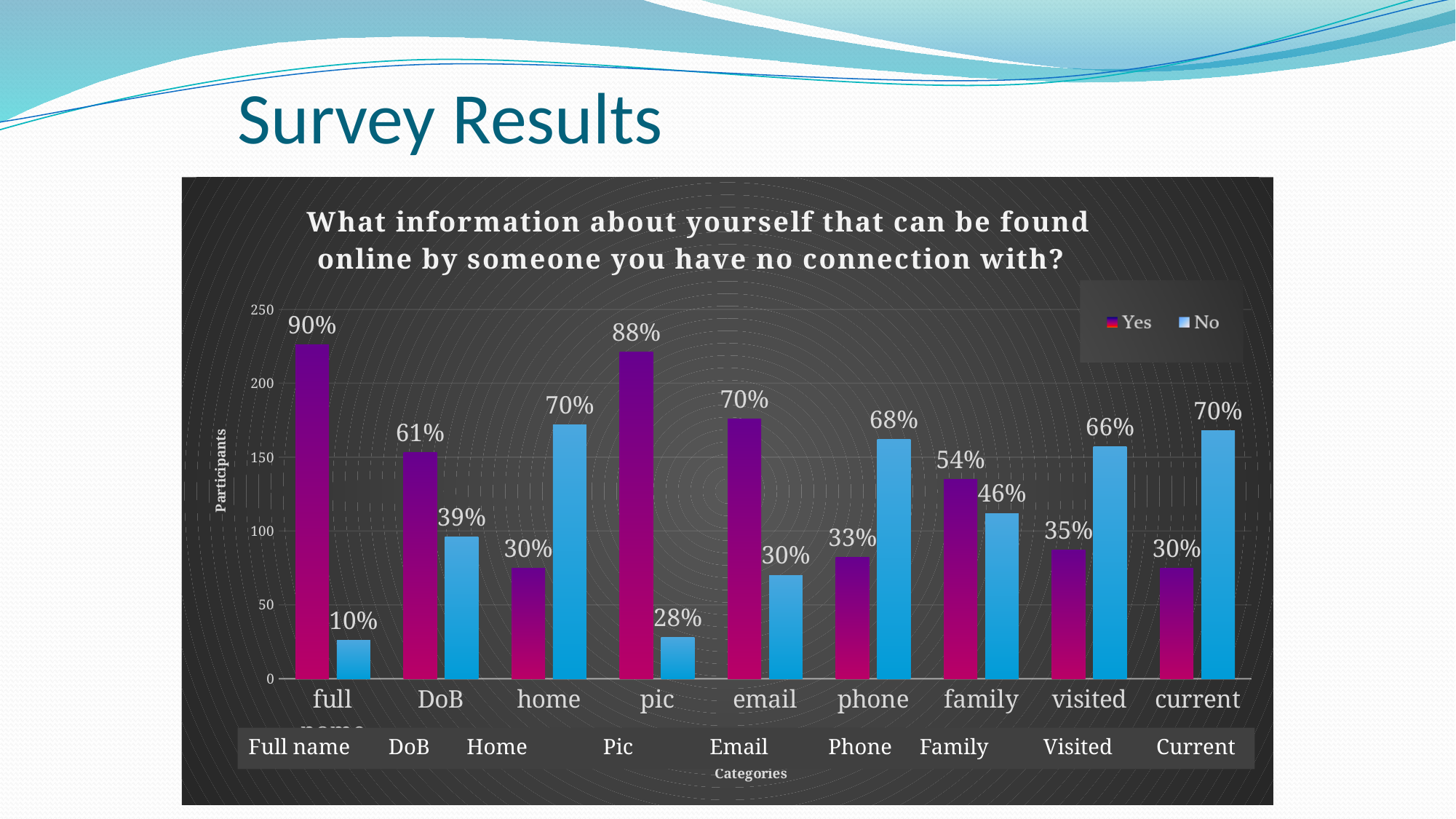
What is the No value for phone? 68% What is the No value for visited? 66% How many categories are shown on the x axis? 9 What is the Yes value for full name? 90% How many series does the legend list? 2 Which category has the lowest No value? full name What kind of chart is shown on the slide? bar chart What is the label of the vertical axis? Participants What is the Yes value for family? 54% Which category has the highest Yes value? full name Which is larger for pic: the Yes value or the No value? Yes What is the difference between the Yes and No values for DoB? 22%